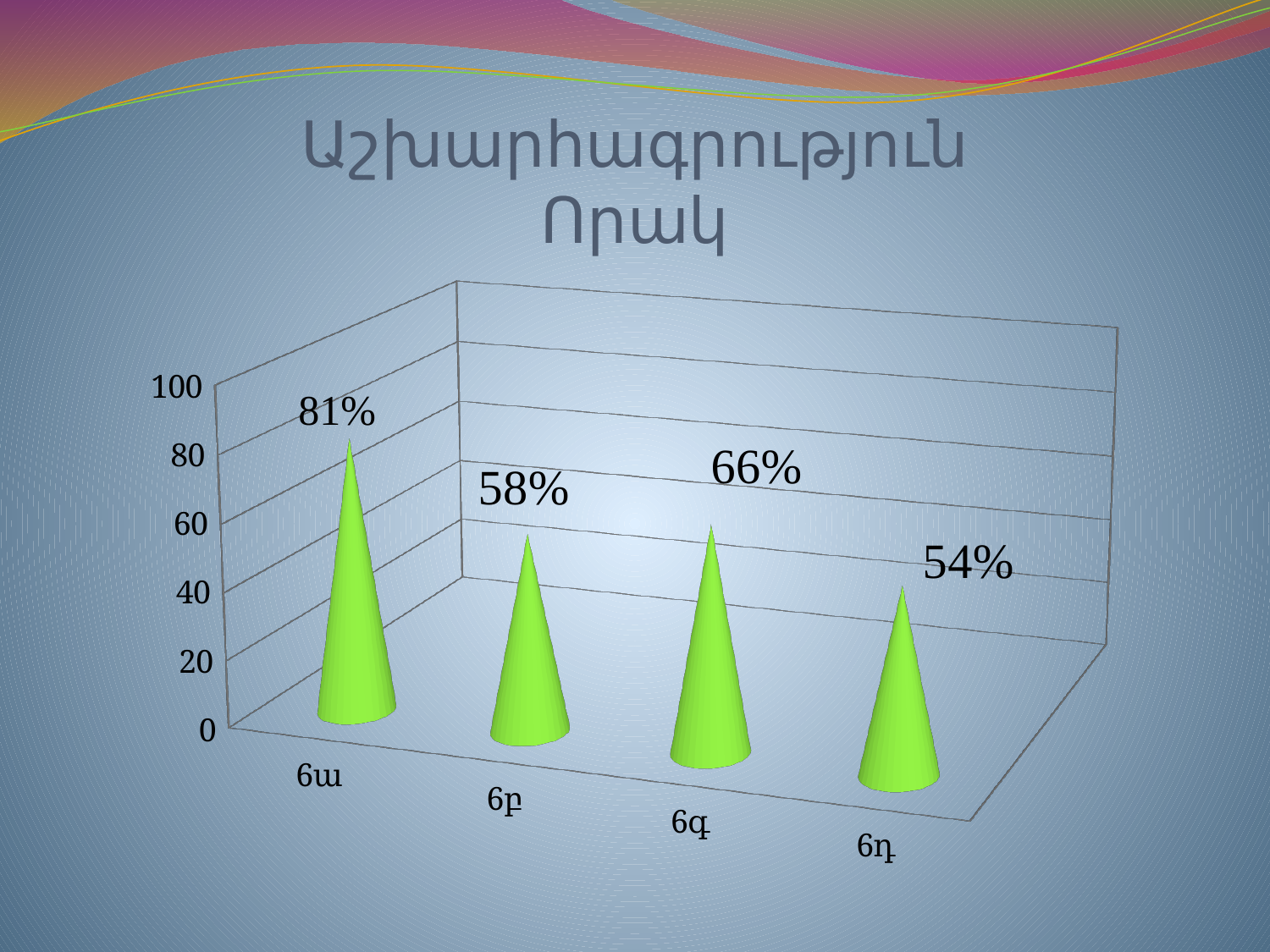
What is the difference between the values for 6գ and 6բ? 8% What is the value for 6դ? 54% Which category has the lowest value? 6դ What is the value for 6գ? 66% What kind of chart is shown on the slide? bar chart How many categories are shown on the x axis? 4 Which is larger, the value for 6բ or the value for 6գ? 6գ What is the difference between the values for 6ա and 6դ? 27% What is the title of the chart on the slide? Աշխարհագրություն Որակ What is the value for 6բ? 58% What is the value for 6ա? 81% Which category has the highest value? 6ա